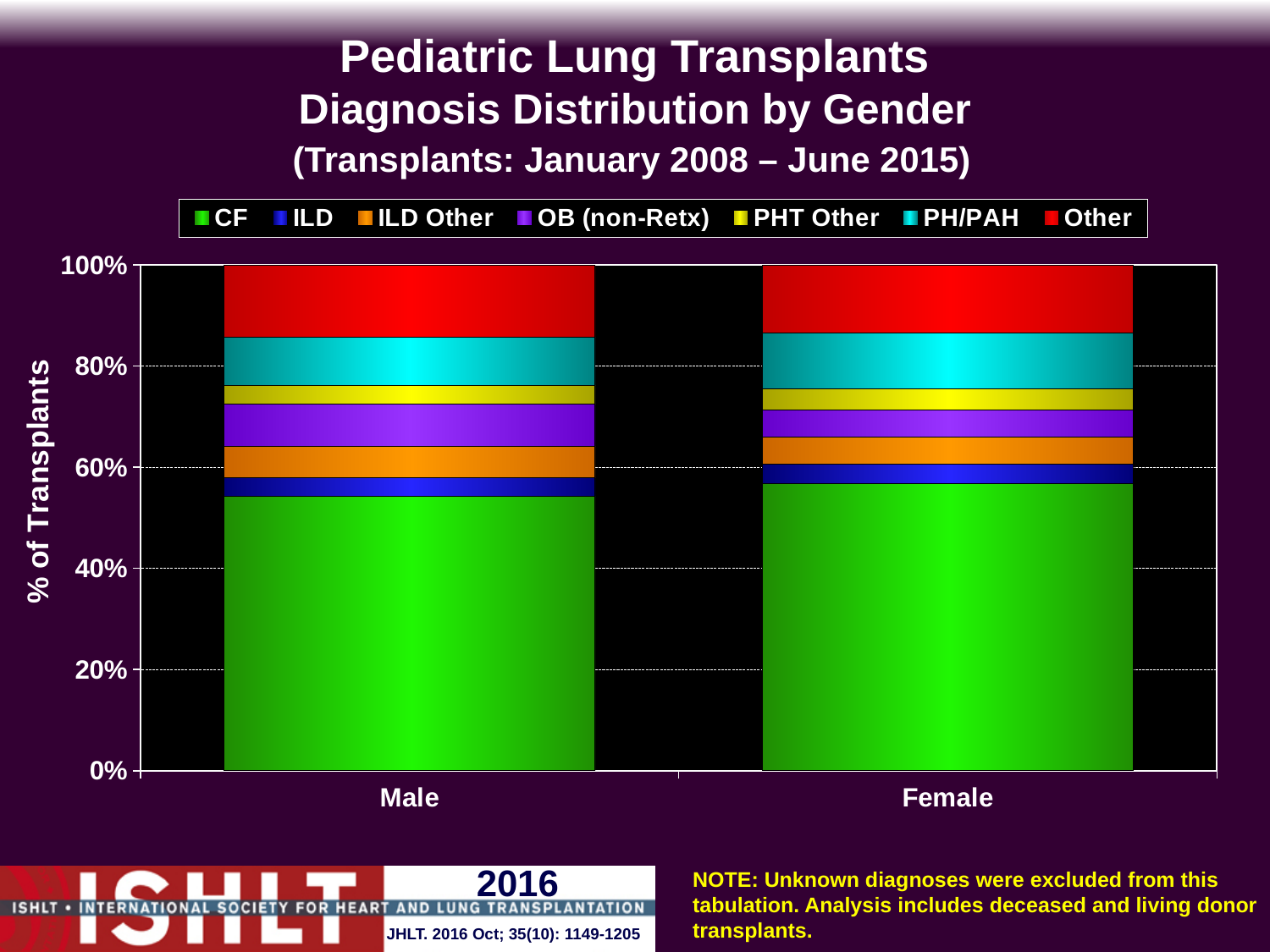
What kind of chart is shown on the slide? stacked bar chart Within the Male bar, which is larger: the CF segment or the Other segment? CF Is the CF value for Male greater or less than 60%? less Is the CF value for Female greater or less than 60%? less What is the total height of the Female stacked bar? 100% How many categories are shown on the x axis? 2 Which diagnosis makes up the largest share of the Female bar? CF What is the label on the y axis? % of Transplants What time period of transplants does the chart title say is covered? January 2008 – June 2015 How many series does the legend list? 7 Is the CF value for Male greater or less than 40%? greater Which diagnosis makes up the largest share of the Male bar? CF